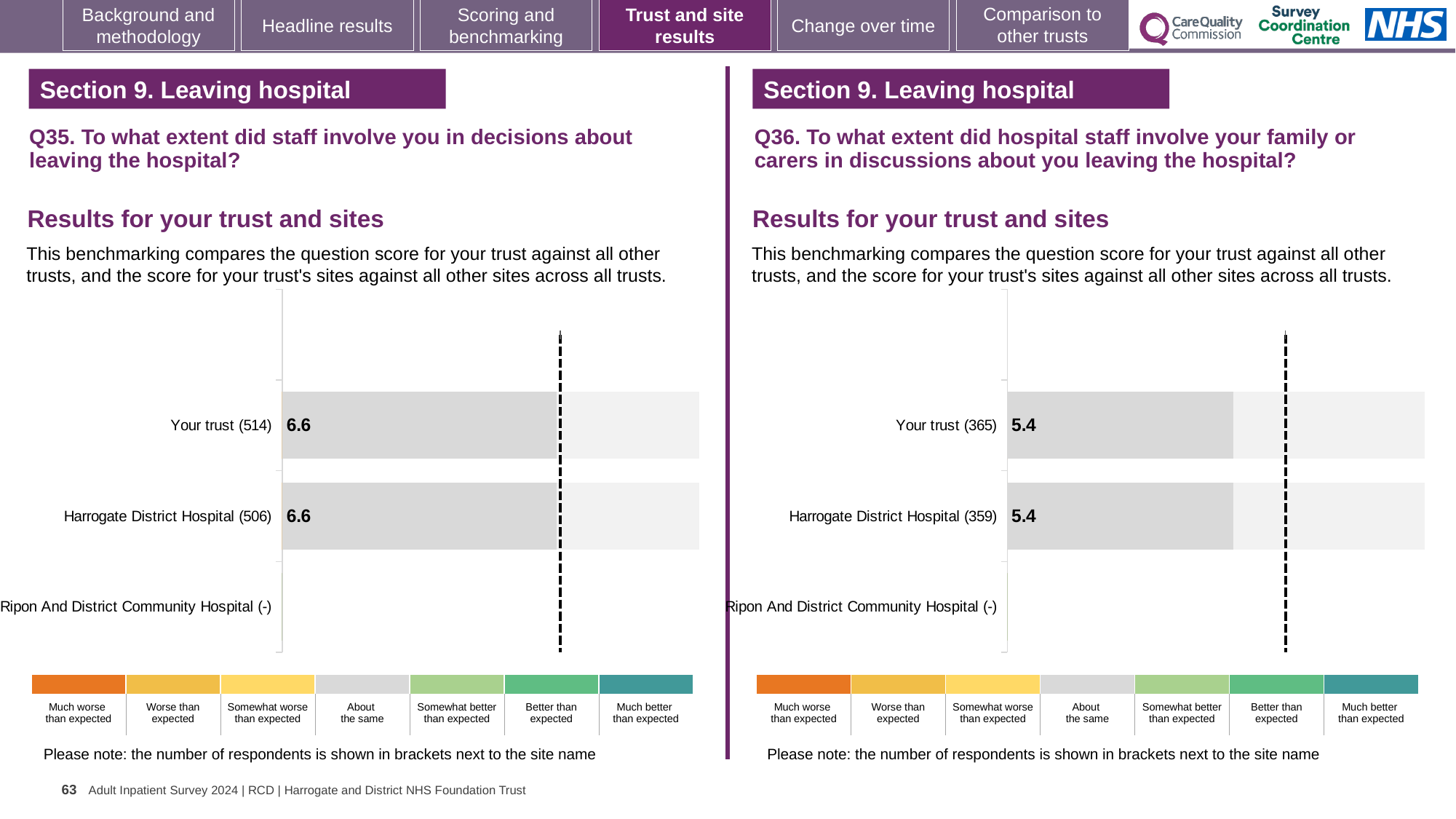
How many benchmark bands are shown in the colour legend below the Q36 chart on the right? 7 How many site/trust categories are listed on the y axis of the Q35 chart on the left? 3 What kind of chart is the Q36 chart on the right? Bar chart In the Q35 chart on the left, which category has no score shown? Ripon And District Community Hospital In the Q36 chart on the right, what is the score for Your trust? 5.4 What is the difference between the Harrogate District Hospital score in the Q35 chart on the left and the Harrogate District Hospital score in the Q36 chart on the right? 1.2 In the Q36 chart on the right, what is the score for Harrogate District Hospital? 5.4 In the Q36 chart on the right, how many respondents are shown in brackets for Harrogate District Hospital? 359 In the Q35 chart on the left, what is the score for Your trust? 6.6 Which is larger: the Your trust score in the Q35 chart on the left or the Your trust score in the Q36 chart on the right? Q35 chart (6.6) In the Q35 chart on the left, how many respondents are shown in brackets for Your trust? 514 In the Q35 chart on the left, what is the score for Harrogate District Hospital? 6.6